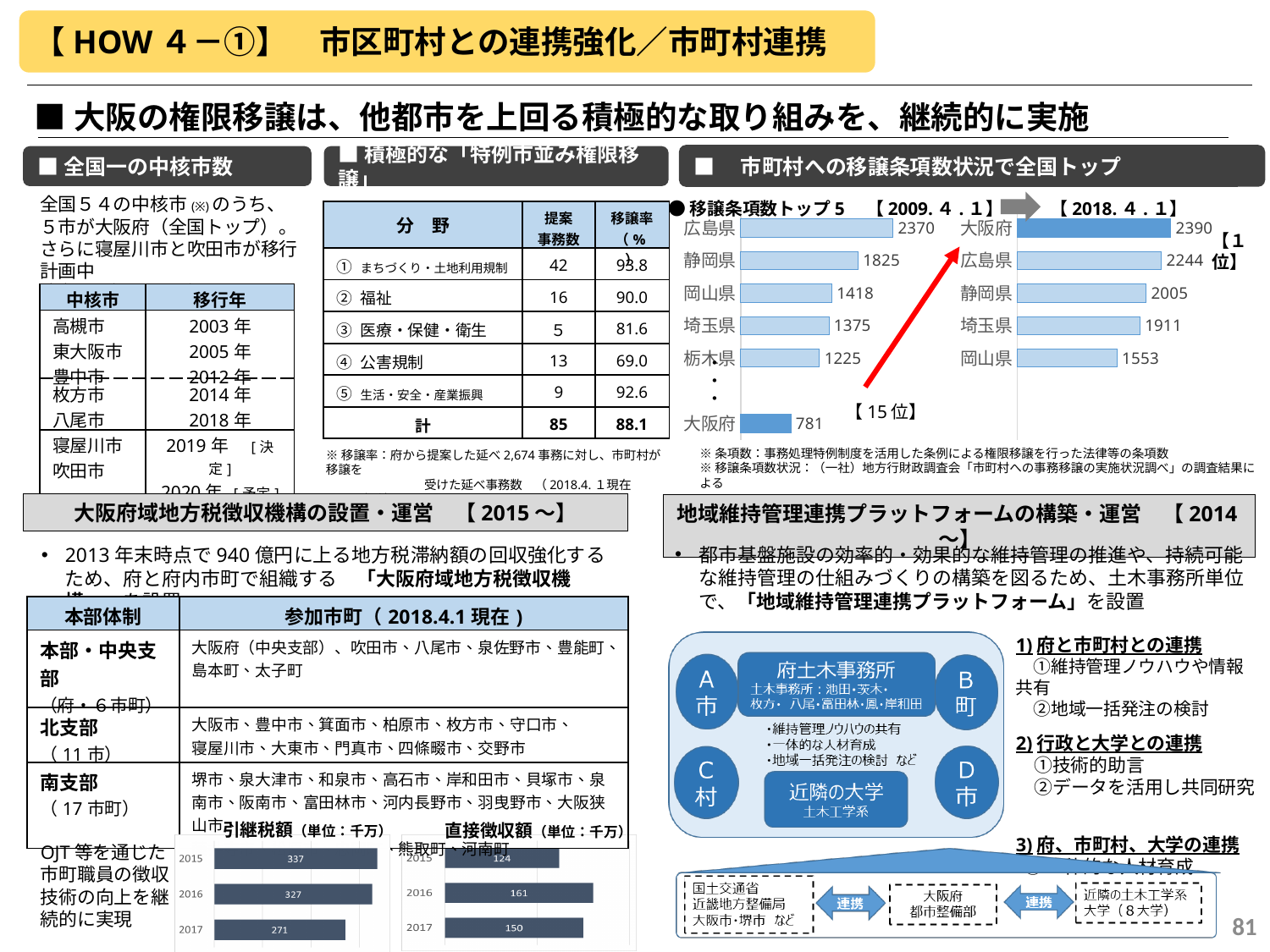
In the 【2018.4.1】 移譲条項数 bar chart, what is the difference between 大阪府 and 広島県? 146 In the 【2018.4.1】 移譲条項数 bar chart, what is the value for 大阪府? 2390 In the 【2009.4.1】 移譲条項数 bar chart, which is larger, 岡山県 or 埼玉県? 岡山県 In the 直接徴収額 chart at the bottom, which year has the highest value? 2016 In the 【2018.4.1】 移譲条項数 bar chart, which prefecture has the lowest value? 岡山県 What kind of chart is the 【2009.4.1】 移譲条項数 chart? bar chart In the 直接徴収額 chart at the bottom, what is the difference between 2016 and 2015? 37 In the 【2009.4.1】 移譲条項数 bar chart, what is the value for 大阪府? 781 In the 引継税額 chart at the bottom left, do the values rise or fall from 2015 to 2017? fall In the 引継税額 chart at the bottom left, what is the value for 2017? 271 How many prefectures are shown in the 【2018.4.1】 移譲条項数 bar chart? 5 In the 【2009.4.1】 移譲条項数 bar chart, what is the value for 広島県? 2370